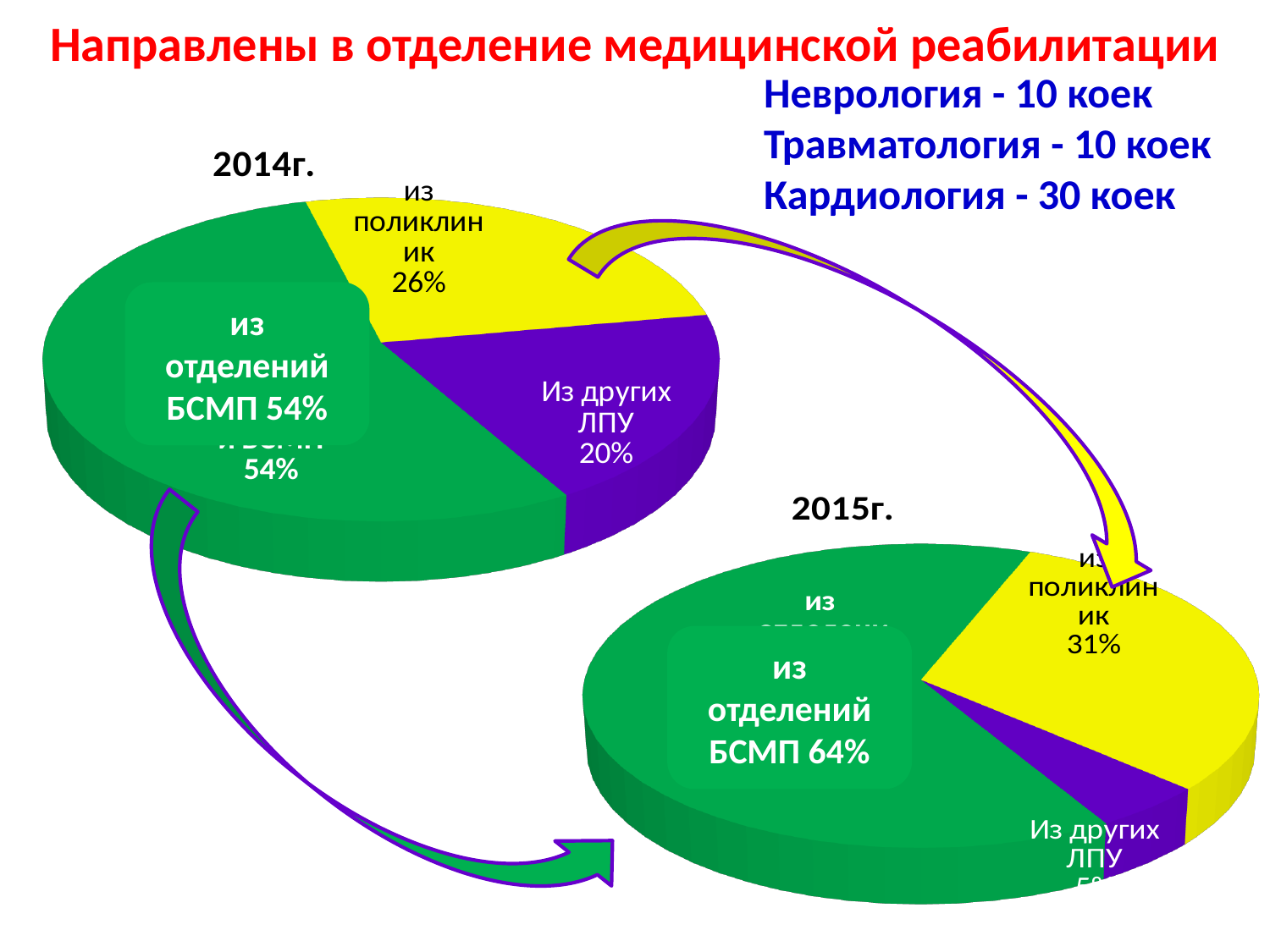
In the 2014г. pie chart, which category has the largest slice? из отделений БСМП What kind of chart is used for the 2014г. data? Pie chart In the 2014г. pie chart, what is the difference between the shares of из отделений БСМП and из поликлиник? 28% In the 2015г. pie chart, what share is labelled for из поликлиник? 31% In the 2015г. pie chart, what share is labelled for из отделений БСМП? 64% In the 2015г. pie chart, which category has the largest slice? из отделений БСМП In the 2014г. pie chart, what share is labelled for из отделений БСМП? 54% In the 2014г. pie chart, what share is labelled for из поликлиник? 26% How many slices does the 2014г. pie chart have? 3 In the 2014г. pie chart, which category has the smallest slice? Из других ЛПУ Which is larger: the share of из отделений БСМП in 2014г. or in 2015г.? 2015г. In the 2014г. pie chart, what share is labelled for Из других ЛПУ? 20%